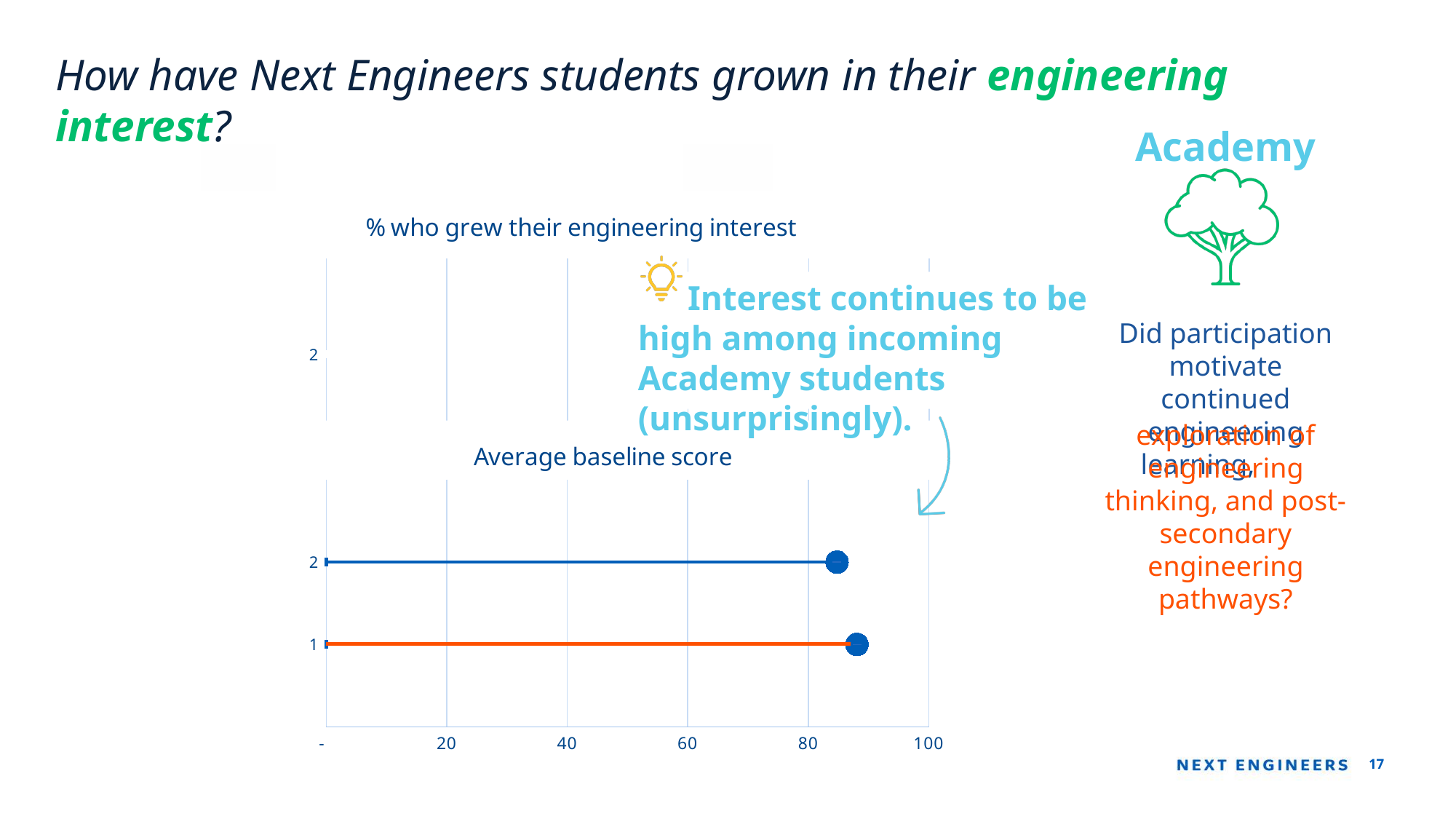
How many categories are plotted in the "Average baseline score" chart? 2 What kind of chart is shown under "Average baseline score"? bar chart In the "Average baseline score" chart, which category has the higher value, 1 or 2? 1 What is the highest tick value shown on the horizontal axis of the chart? 100 In the "Average baseline score" chart, is the value for category 2 greater or less than 80? greater In the "Average baseline score" chart, is the value for category 1 greater or less than 80? greater In the "Average baseline score" chart, is the value for category 2 greater or less than 60? greater